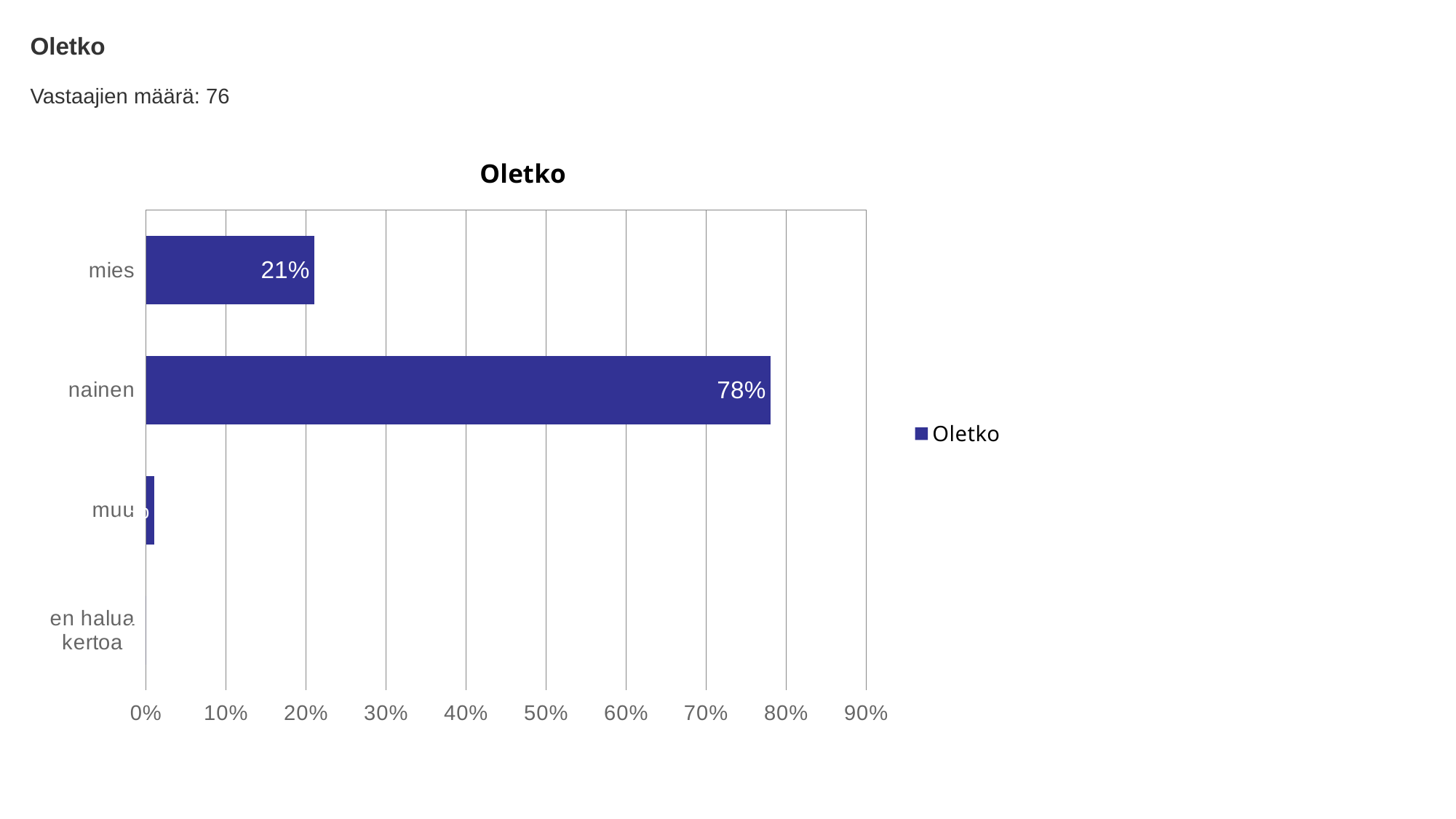
What is the value for nainen? 78% What is the value for mies? 21% What is the title of the chart? Oletko How many series does the legend list? 1 Which is larger, the value for mies or the value for nainen? nainen What is the difference between the values for nainen and mies? 57% Which category has the highest value? nainen What kind of chart is shown on the slide? bar chart Is the value for nainen greater or less than 70%? greater Which category has the lowest value? en halua kertoa Is the value for muu greater or less than 10%? less How many categories are shown on the chart? 4